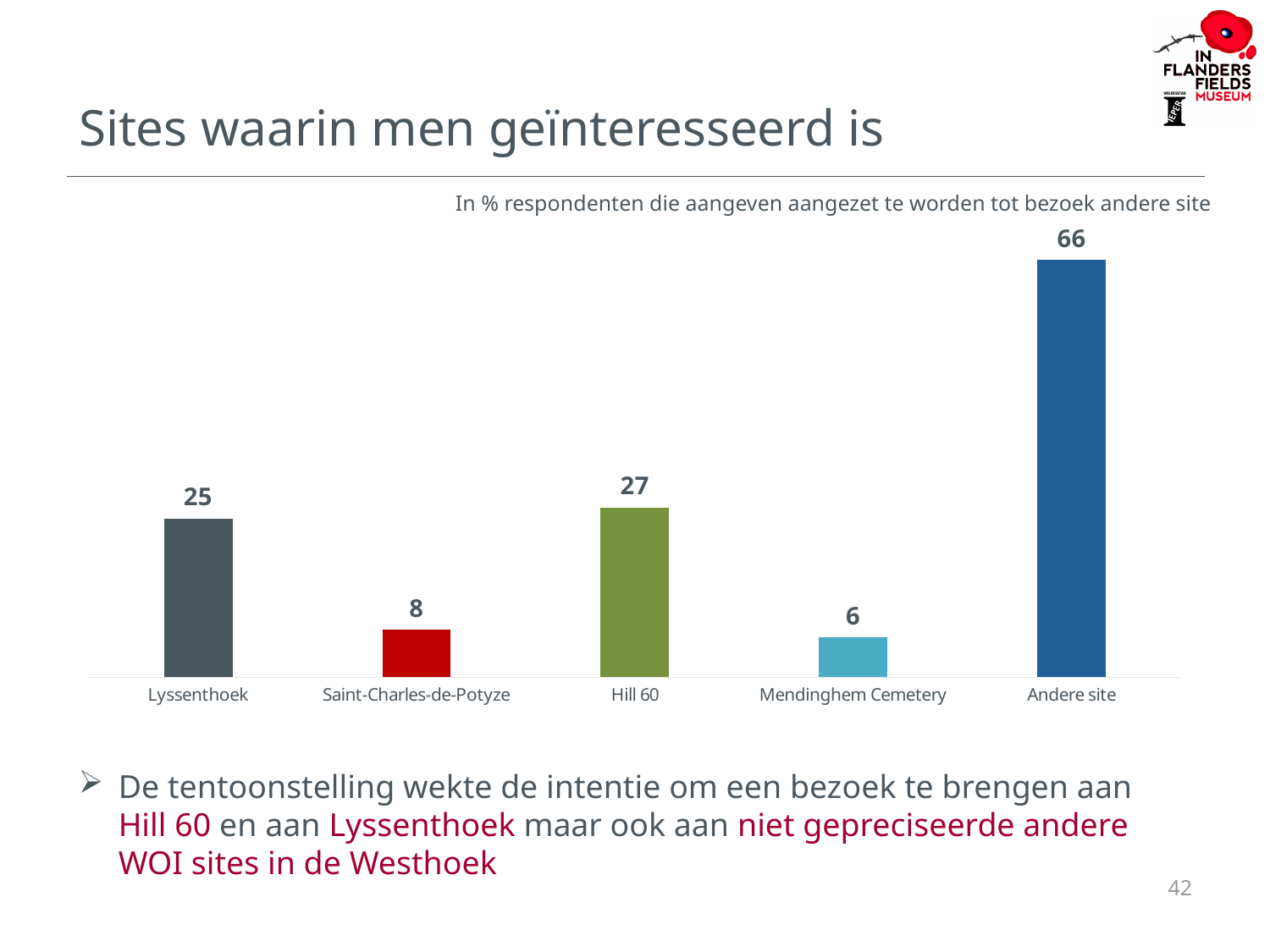
What is the difference between the values for Saint-Charles-de-Potyze and Mendinghem Cemetery? 2 Which category has the highest value? Andere site What is the value for Mendinghem Cemetery? 6 Which is larger, the value for Hill 60 or the value for Lyssenthoek? Hill 60 Which category has the lowest value? Mendinghem Cemetery What is the value for Andere site? 66 How many categories are shown in the chart? 5 What kind of chart is shown on the slide? Bar chart What is the value for Lyssenthoek? 25 What is the difference between the values for Andere site and Hill 60? 39 What is the value for Hill 60? 27 What is the value for Saint-Charles-de-Potyze? 8